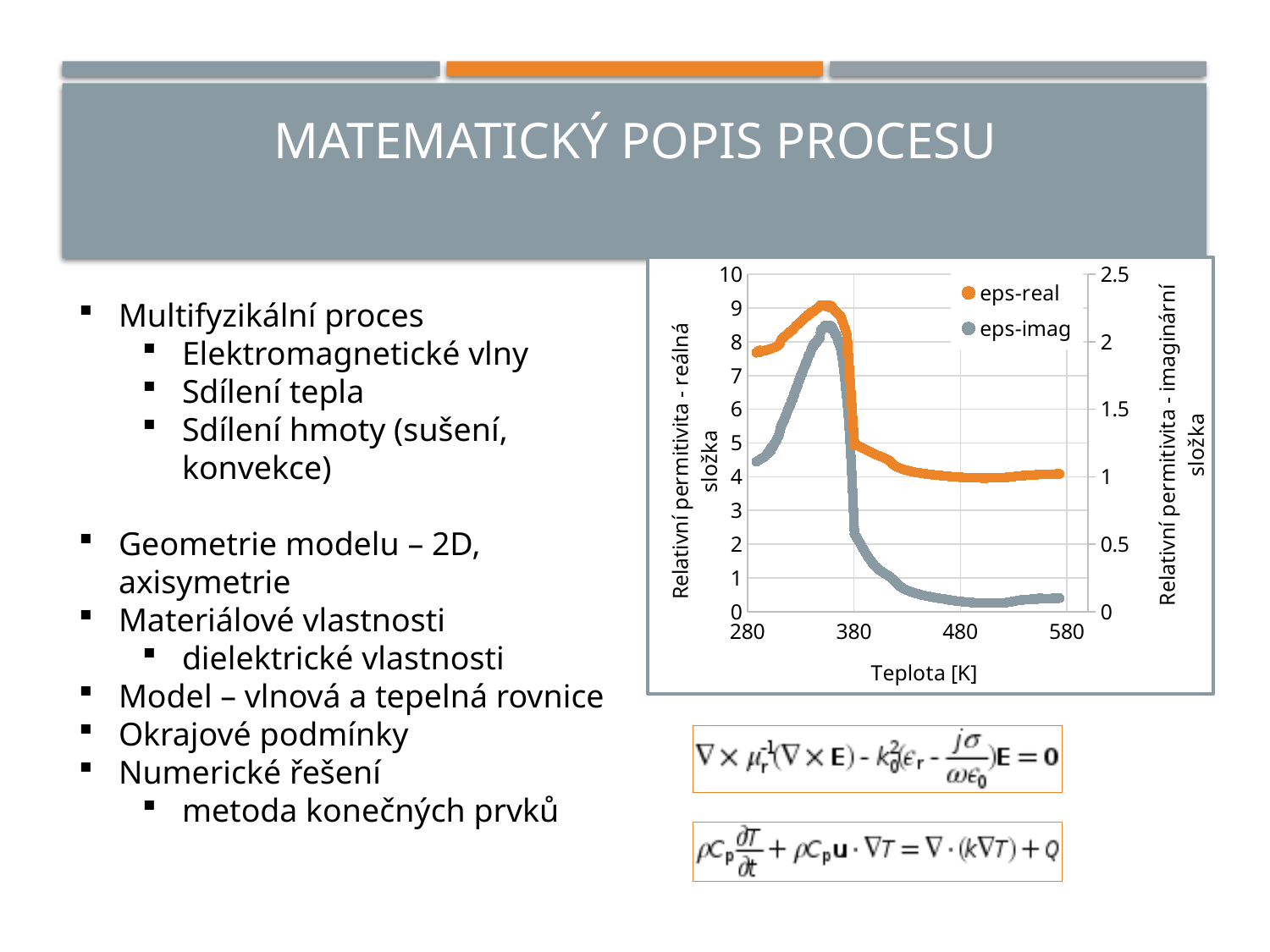
Is the value of eps-imag at 580 K greater or less than 0.5 on the right axis? less How many series does the chart legend list? 2 Which series is plotted in orange? eps-real What are the names of the two series in the chart legend? eps-real and eps-imag Does the eps-imag series rise or fall between 280 K and about 350 K? rise Is the value of eps-real at 580 K greater or less than 5 on the left axis? less What is the highest tick value shown on the right y axis? 2.5 What kind of chart is shown on the slide? scatter chart Is the value of eps-real at 280 K greater or less than 7 on the left axis? greater What is the title of the x axis of the chart? Teplota [K] Does the eps-real series rise or fall between 380 K and 580 K? fall